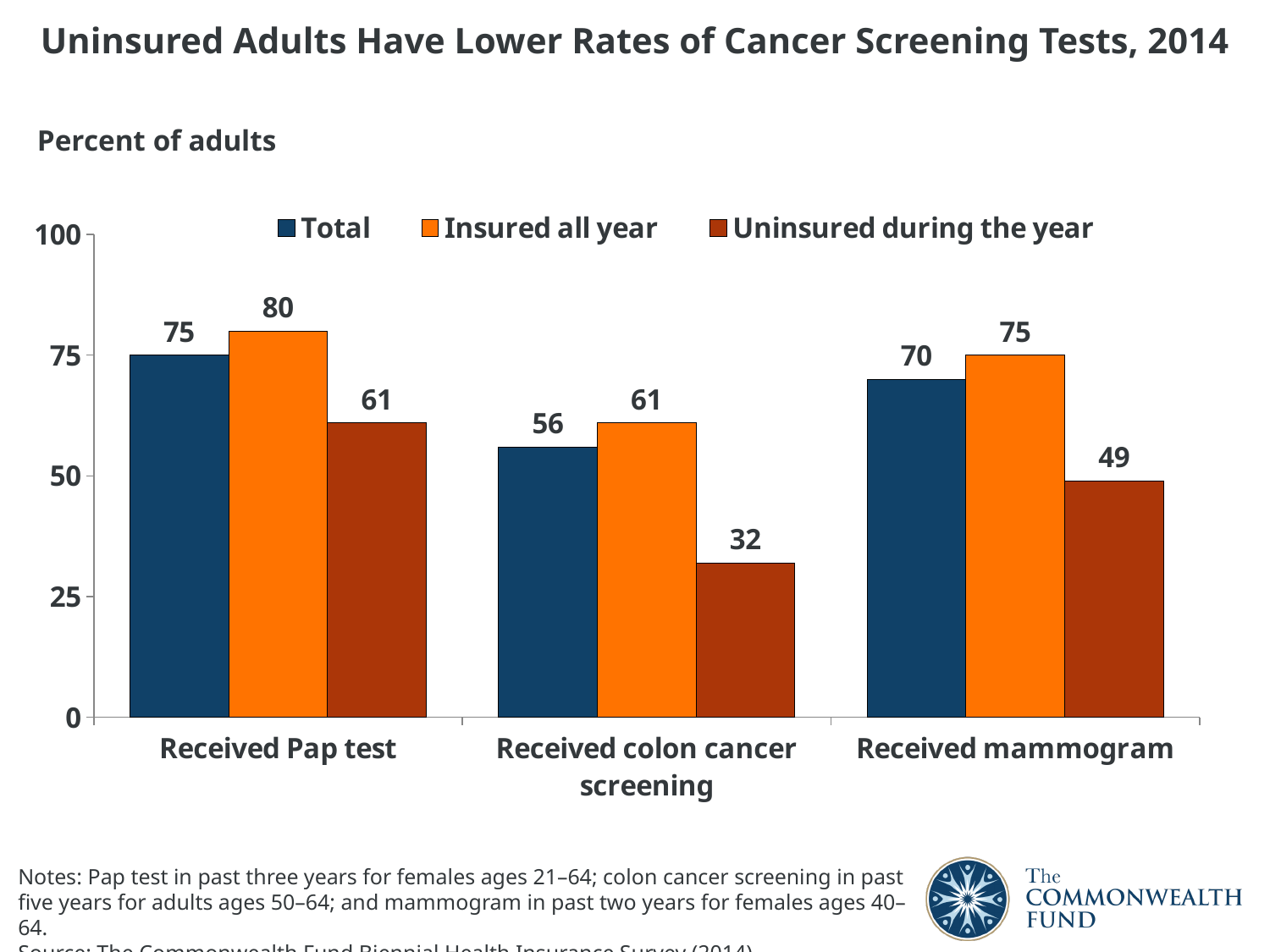
What is the difference between Insured all year and Uninsured during the year for Received mammogram? 26 What is the value for Insured all year in the Received Pap test category? 80 How many series does the legend list? 3 Which category has the highest value for Insured all year? Received Pap test What is the difference between Insured all year and Uninsured during the year for Received colon cancer screening? 29 What is the title of the chart? Uninsured Adults Have Lower Rates of Cancer Screening Tests, 2014 What kind of chart is shown on the slide? Bar chart Which is larger: the Total value for Received Pap test or the Total value for Received mammogram? Received Pap test Which category has the lowest value for Uninsured during the year? Received colon cancer screening How many categories are shown on the x axis? 3 What is the Total value for Received mammogram? 70 What is the value for Uninsured during the year in the Received colon cancer screening category? 32